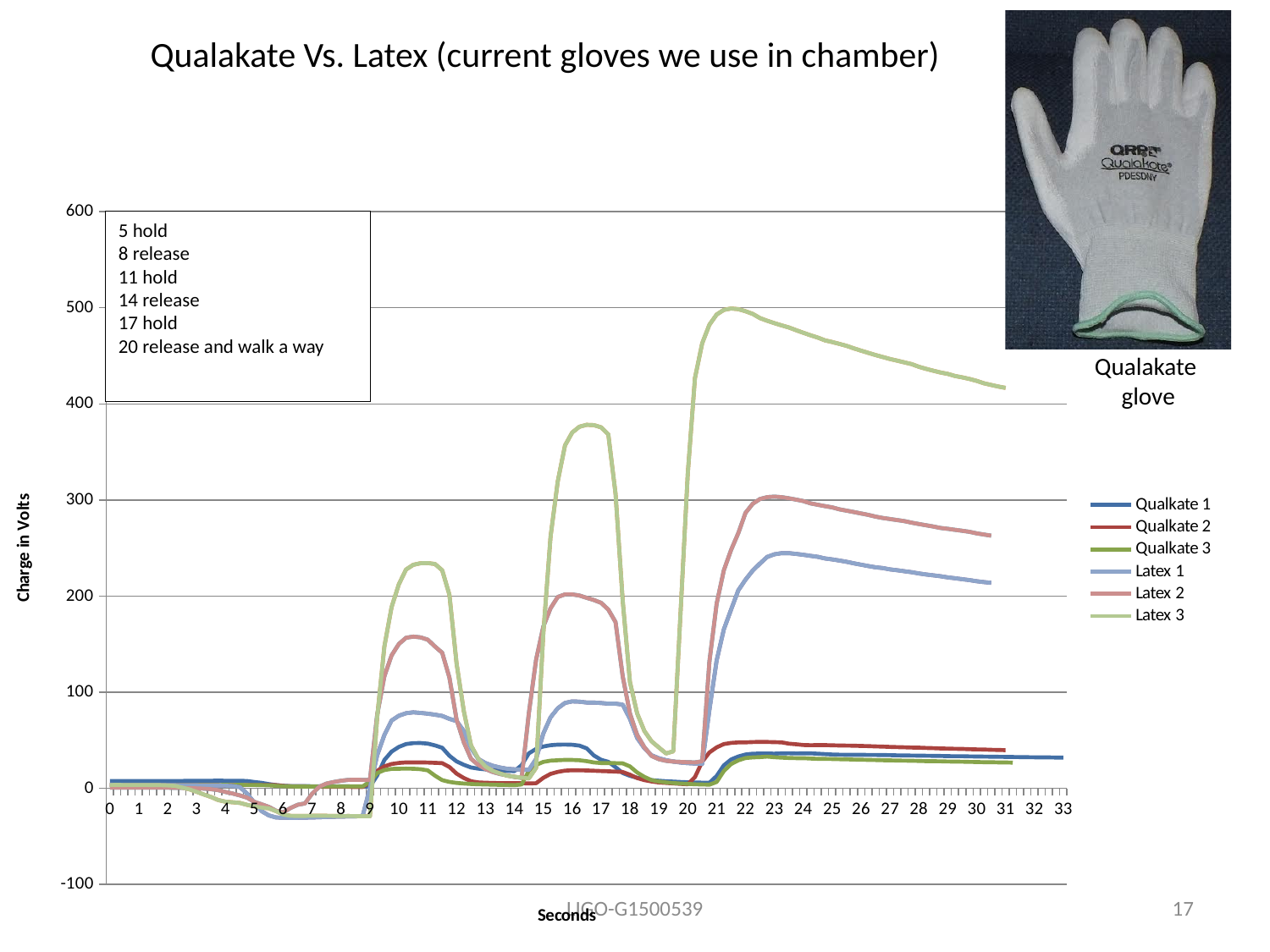
What kind of chart is shown on the slide? line chart Between 21 and 30 seconds, does the Latex 3 line rise or fall? fall Which series reaches the highest value on the chart? Latex 3 Is the peak value of Qualkate 1 greater or less than 100? less Is the value of Latex 3 at 30 seconds greater or less than 400? greater Is the peak value of Latex 2 greater or less than 200? greater What is the label of the vertical axis? Charge in Volts How many series does the chart legend list? 6 What is the label of the horizontal axis? Seconds At 30 seconds, which is higher, Latex 2 or Latex 1? Latex 2